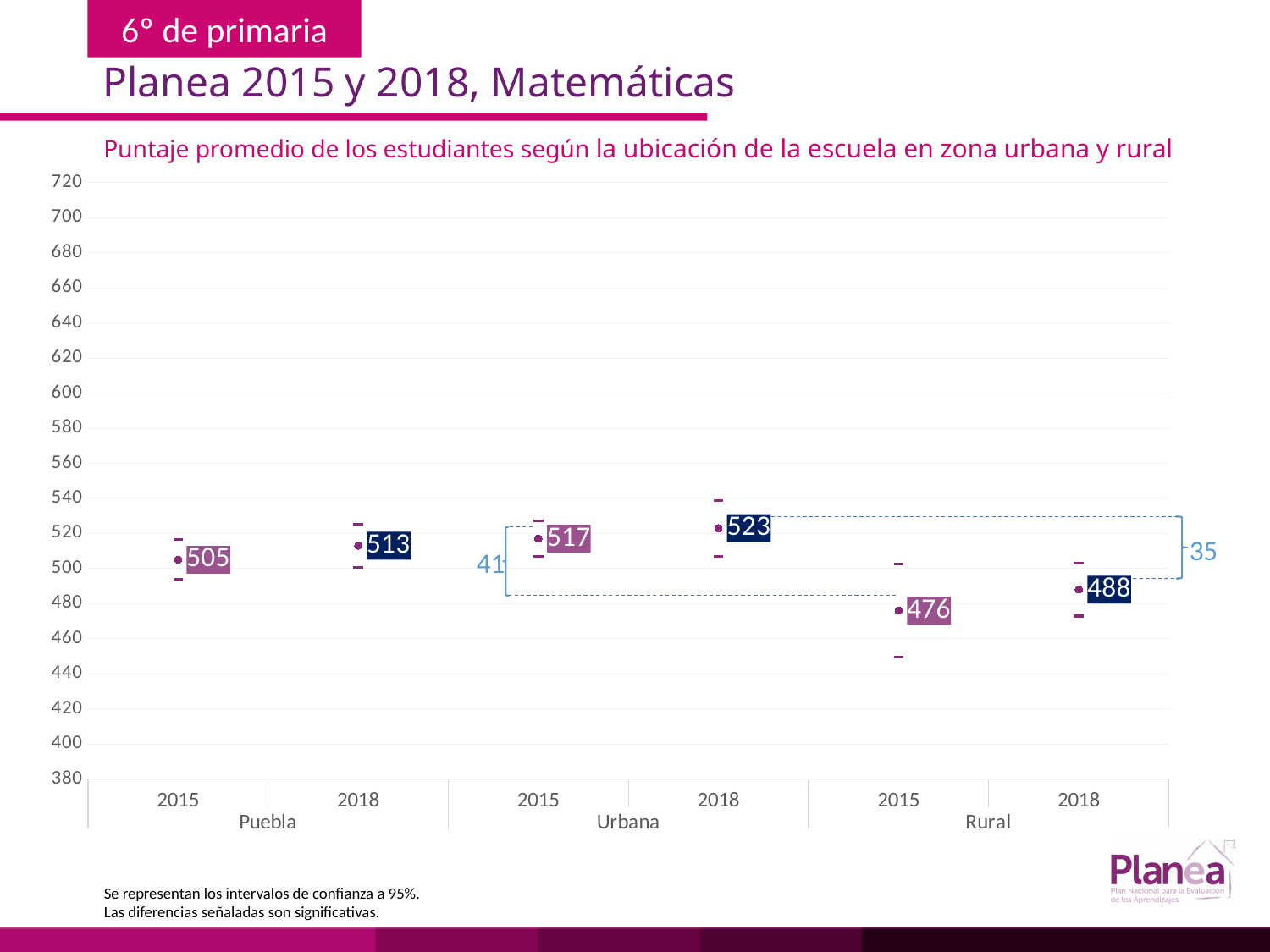
Which is larger, the Puebla 2018 score or the Urbana 2015 score? Urbana 2015 What is the average score for Rural schools in 2015? 476 Which group and year has the lowest average score? Rural 2015 What is the average score for Puebla in 2015? 505 Did the Puebla average score rise or fall from 2015 to 2018? rise What is the average score for Puebla in 2018? 513 By how many points did the Rural average score change from 2015 to 2018? 12 What is the difference between the Urbana and Rural average scores in 2015? 41 What is the difference between the Urbana and Rural average scores in 2018? 35 What is the average score for Urbana schools in 2018? 523 Which group and year has the highest average score? Urbana 2018